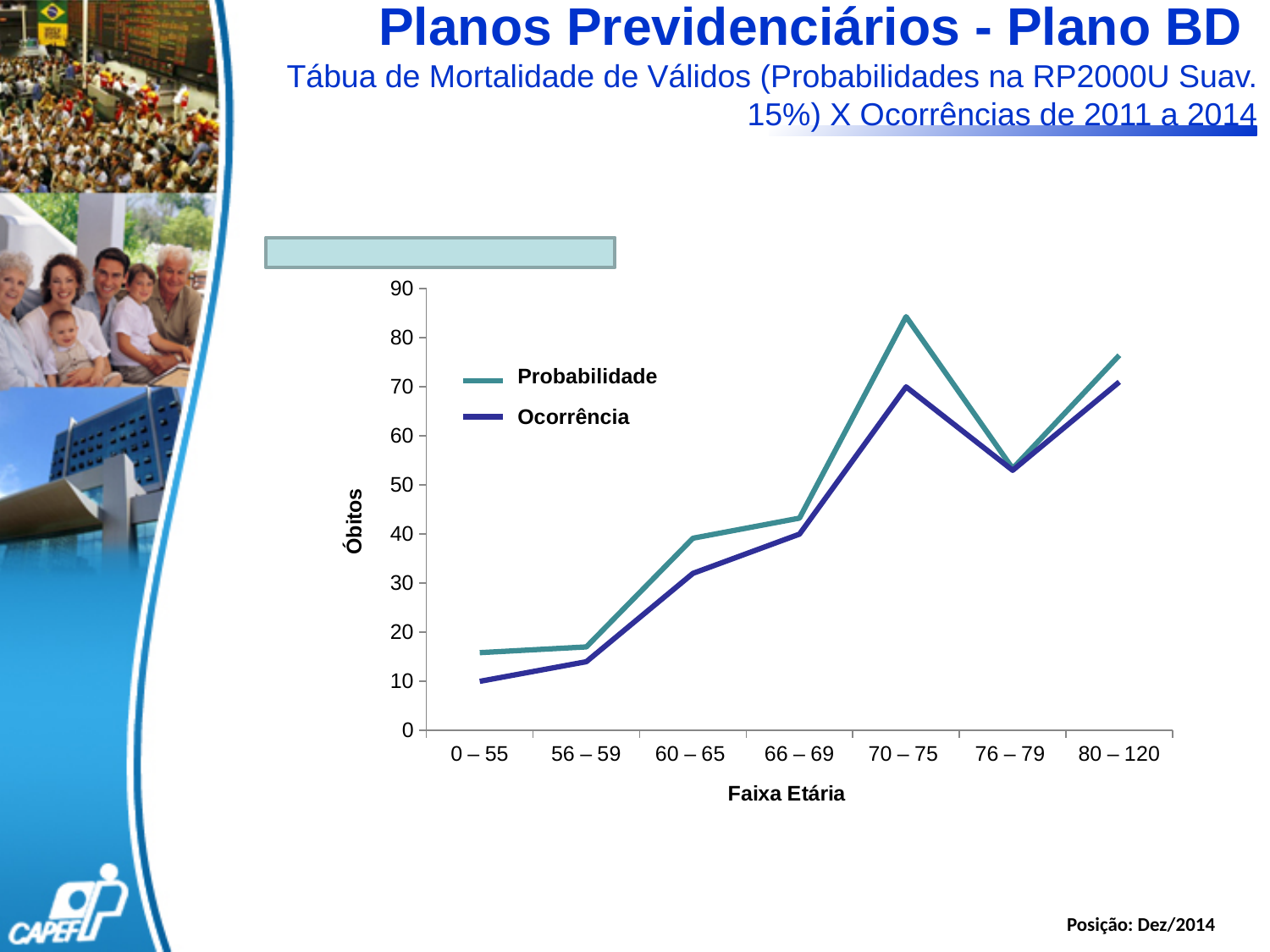
What kind of chart is shown on the slide? line chart Which age range has the lowest value for the Ocorrência series? 0 – 55 Is the Probabilidade value for 80 – 120 greater or less than 70? greater Do the values of the Ocorrência series rise or fall from 0 – 55 to 70 – 75? rise Is the Ocorrência value for 60 – 65 greater or less than 40? less What is the title of the x axis? Faixa Etária Which age range has the highest value for the Probabilidade series? 70 – 75 How many series does the legend list? 2 How many age ranges (categories) are shown on the x axis? 7 Is the Probabilidade value for 70 – 75 greater or less than 80? greater At 70 – 75, which series has the larger value, Probabilidade or Ocorrência? Probabilidade